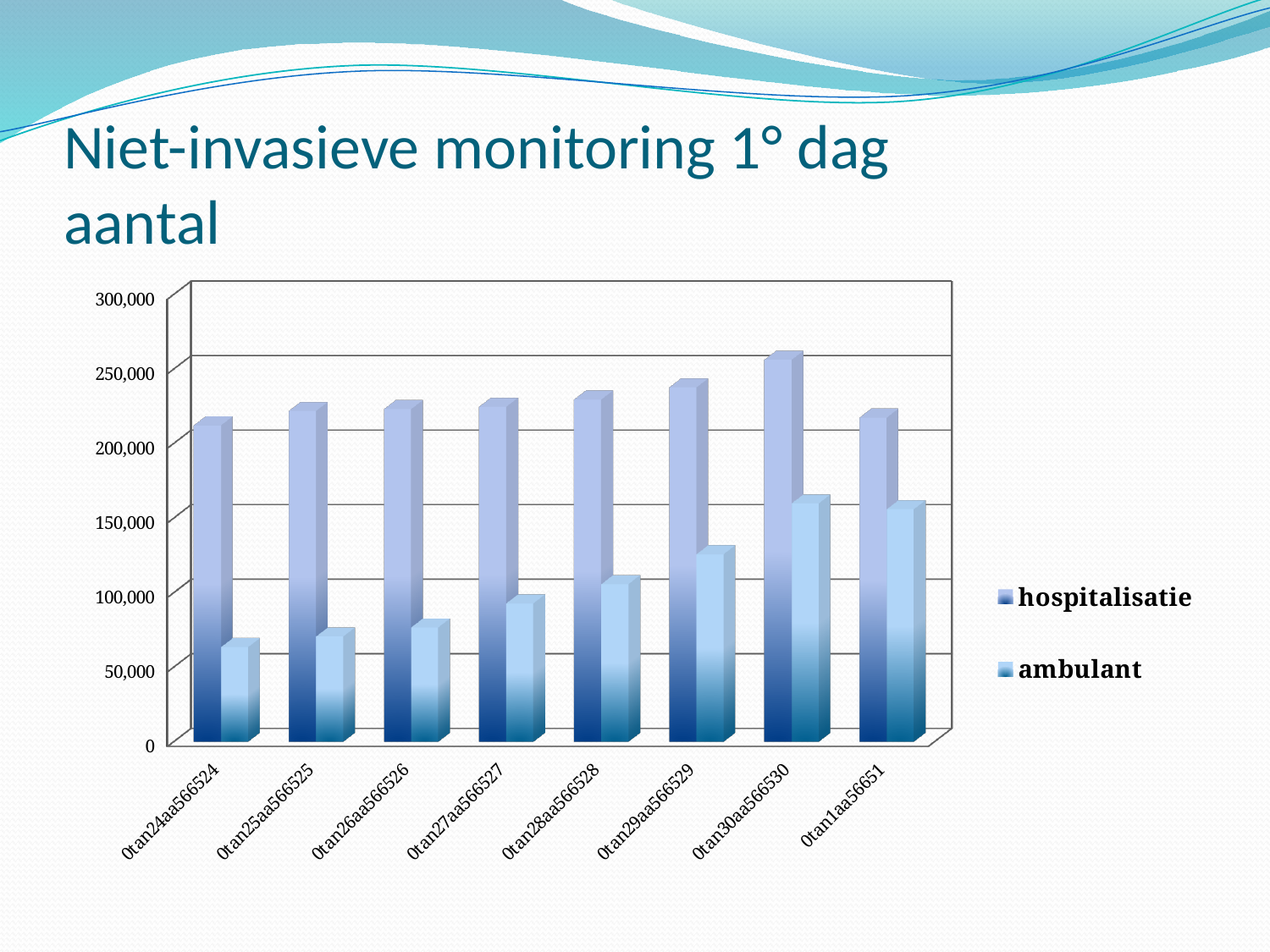
How many series does the legend list? 2 Is the hospitalisatie value for 0tan24aa566524 greater or less than 200,000? greater What kind of chart is shown on the slide? bar chart How many categories are shown along the x axis? 8 For 0tan27aa566527, which is larger: hospitalisatie or ambulant? hospitalisatie What are the two series named in the legend? hospitalisatie and ambulant Do the ambulant values generally rise or fall from 0tan24aa566524 to 0tan30aa566530? rise Which category has the highest hospitalisatie value? 0tan30aa566530 Which category has the lowest ambulant value? 0tan24aa566524 Is the ambulant value for 0tan30aa566530 greater or less than 150,000? greater Is the ambulant value for 0tan29aa566529 greater or less than 100,000? greater